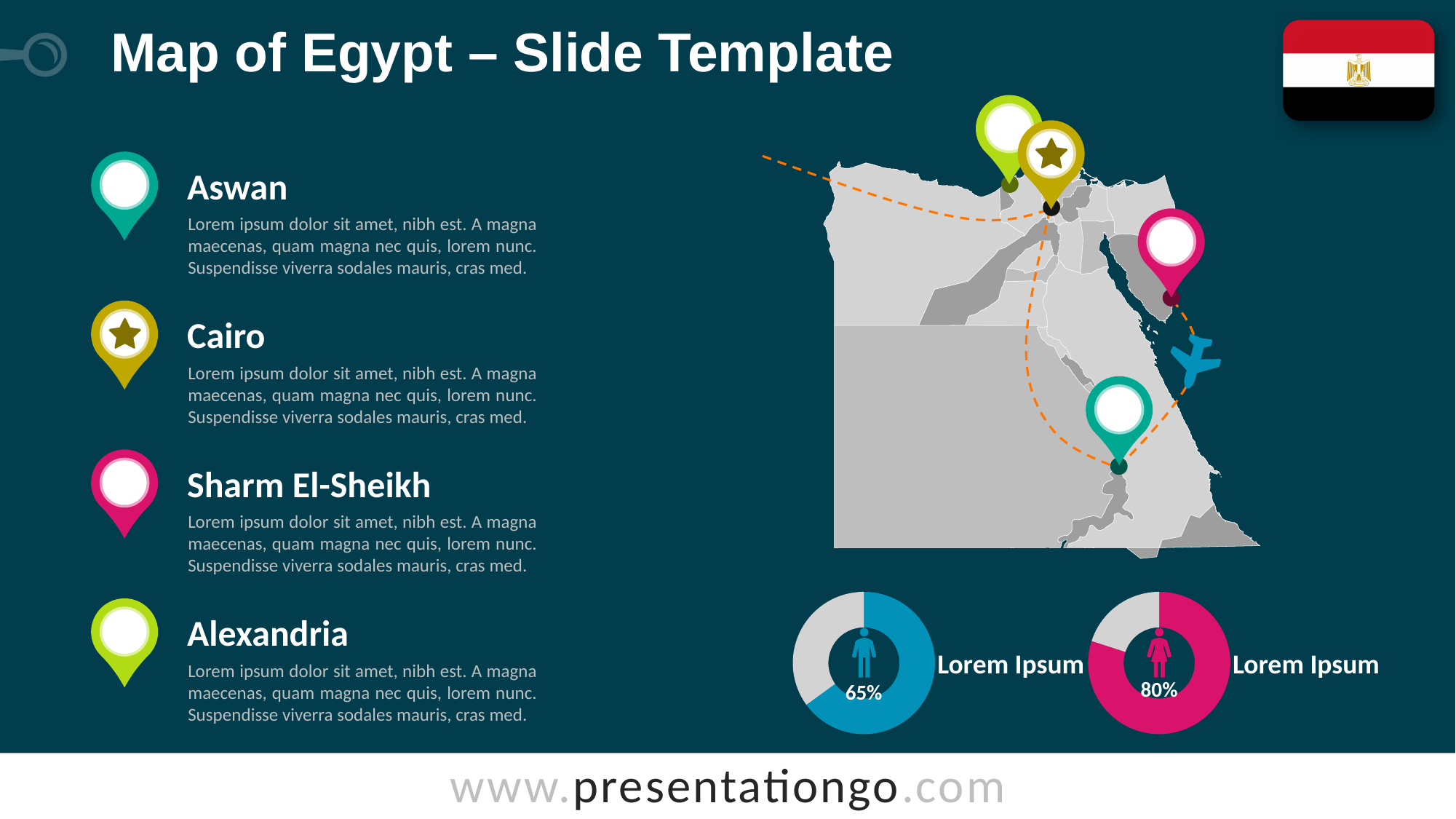
What colour is the filled portion of the left donut chart? Blue Is the value in the left donut chart greater or less than 50%? greater What value is shown in the right donut chart with the female figure icon? 80% What kind of charts are shown at the bottom right of the slide? Donut (pie) charts What value is shown in the left donut chart with the male figure icon? 65% Which donut chart shows the larger value, the blue one on the left or the pink one on the right? The pink one on the right What is the difference between the value in the right donut chart and the value in the left donut chart? 15 percentage points Is the value in the right donut chart greater or less than 75%? greater Which donut chart shows the smaller value? The left (blue) donut chart, 65% What share of the right donut chart is filled in pink? 80% What label appears next to the right donut chart? Lorem Ipsum How many donut charts are on the slide? 2